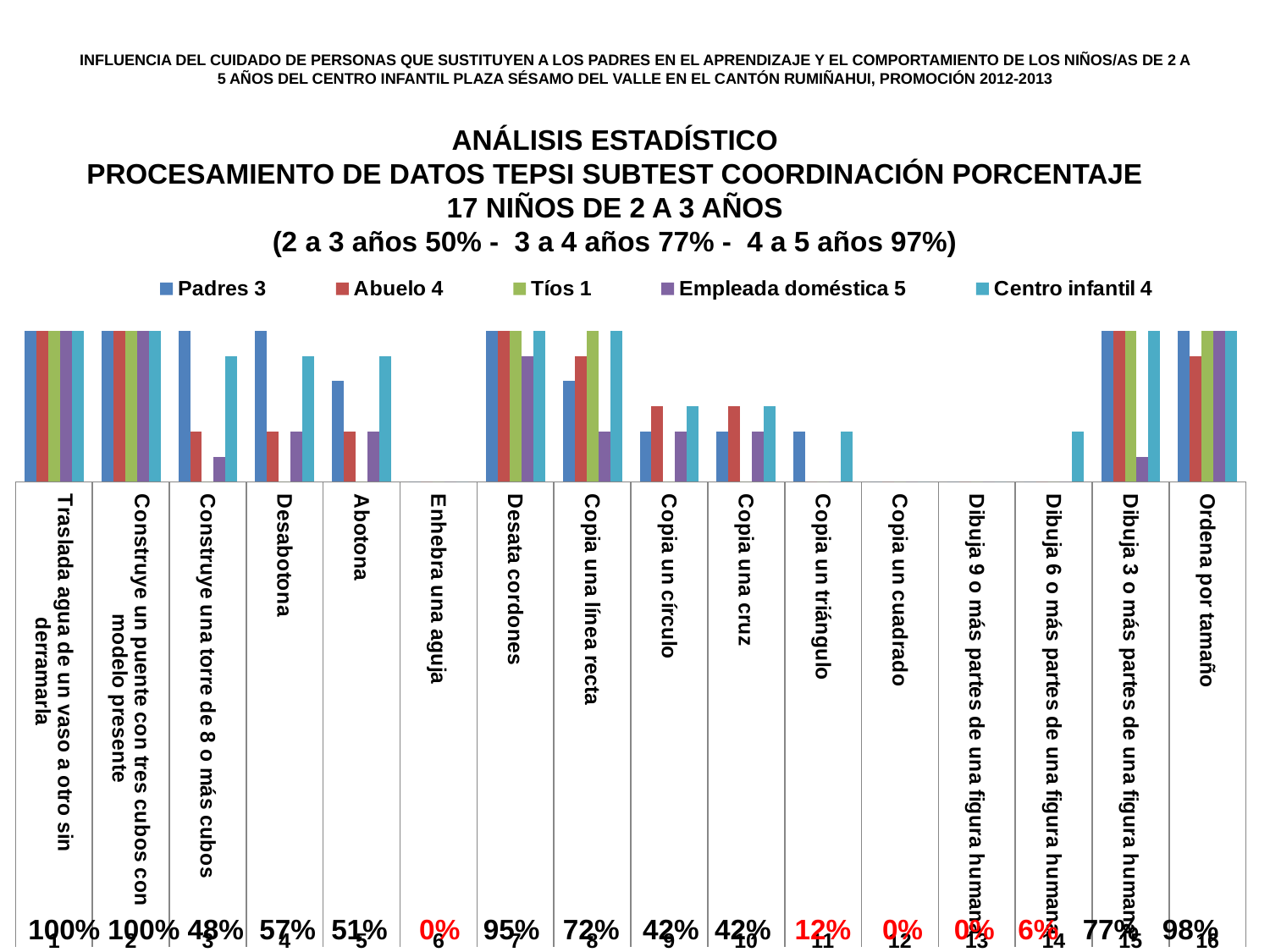
For 'Dibuja 6 o más partes de una figura humana', which is the only series with a visible bar? Centro infantil 4 For 'Construye una torre de 8 o más cubos', which is larger: the Padres 3 bar or the Abuelo 4 bar? Padres 3 Which series is listed last in the legend? Centro infantil 4 Which series is listed first in the legend? Padres 3 What percentage is printed beneath the category 'Copia una línea recta'? 72% How many categories are shown along the x axis of the chart? 16 What kind of chart is shown on the slide? bar chart For 'Ordena por tamaño', which series has the lowest bar? Abuelo 4 How many series does the legend list? 5 What percentage is printed beneath the category 'Desata cordones'? 95% For 'Copia un círculo', which is larger: the Abuelo 4 bar or the Padres 3 bar? Abuelo 4 For 'Dibuja 3 o más partes de una figura humana', which series has the lowest bar? Empleada doméstica 5